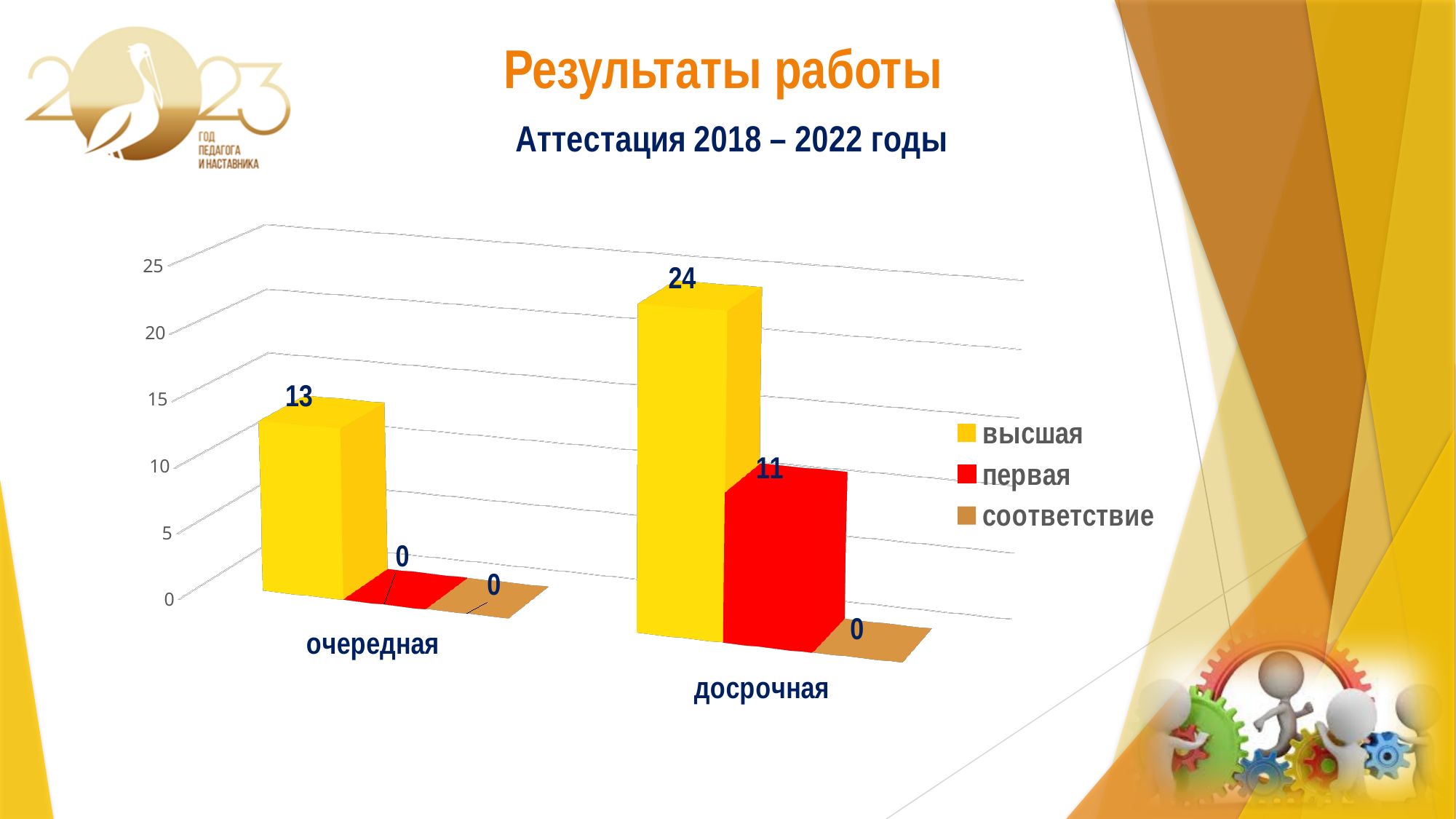
How many categories are shown on the x axis? 2 Which is larger: высшая for очередная or первая for досрочная? высшая for очередная What is the value for первая in the очередная category? 0 What is the value for первая in the досрочная category? 11 What is the value for высшая in the досрочная category? 24 What kind of chart is shown on the slide? bar chart How many series does the legend list? 3 What is the value for соответствие in the досрочная category? 0 What is the value for высшая in the очередная category? 13 Which category has the highest value for высшая? досрочная What is the difference between the высшая values for досрочная and очередная? 11 What is the difference between высшая and первая in the досрочная category? 13